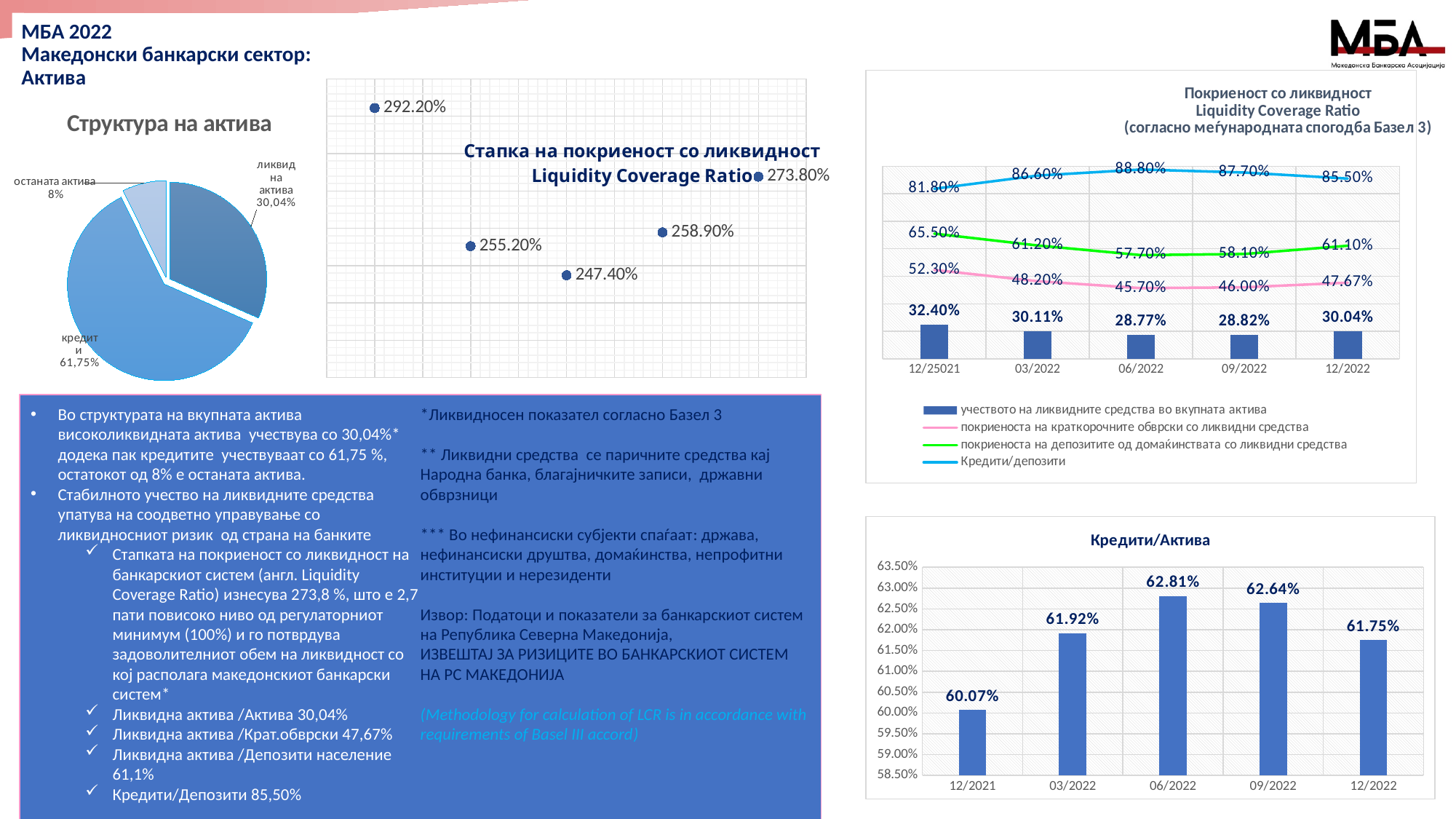
In the chart 'Кредити/Актива', which period has the highest value? 06/2022 In the scatter chart 'Стапка на покриеност со ликвидност Liquidity Coverage Ratio', what is the highest value shown? 292.20% In the chart 'Кредити/Актива', what is the difference between the values for 06/2022 and 12/2021? 2.74 percentage points In the pie chart 'Структура на актива', which slice is the smallest? останата актива How many slices does the pie chart 'Структура на актива' have? 3 How many series does the legend of the chart 'Покриеност со ликвидност Liquidity Coverage Ratio' list? 4 In the scatter chart 'Стапка на покриеност со ликвидност Liquidity Coverage Ratio', what is the lowest value shown? 247.40% In the pie chart 'Структура на актива', what share does 'кредити' have? 61,75% What type of chart is 'Кредити/Актива'? Bar chart How many data points are plotted in the scatter chart 'Стапка на покриеност со ликвидност Liquidity Coverage Ratio'? 5 In the chart 'Покриеност со ликвидност Liquidity Coverage Ratio', what is the value of the bar series 'учеството на ликвидните средства во вкупната актива' for 12/2022? 30.04% In the chart 'Покриеност со ликвидност Liquidity Coverage Ratio', what is the value of 'Кредити/депозити' for 06/2022? 88.80%